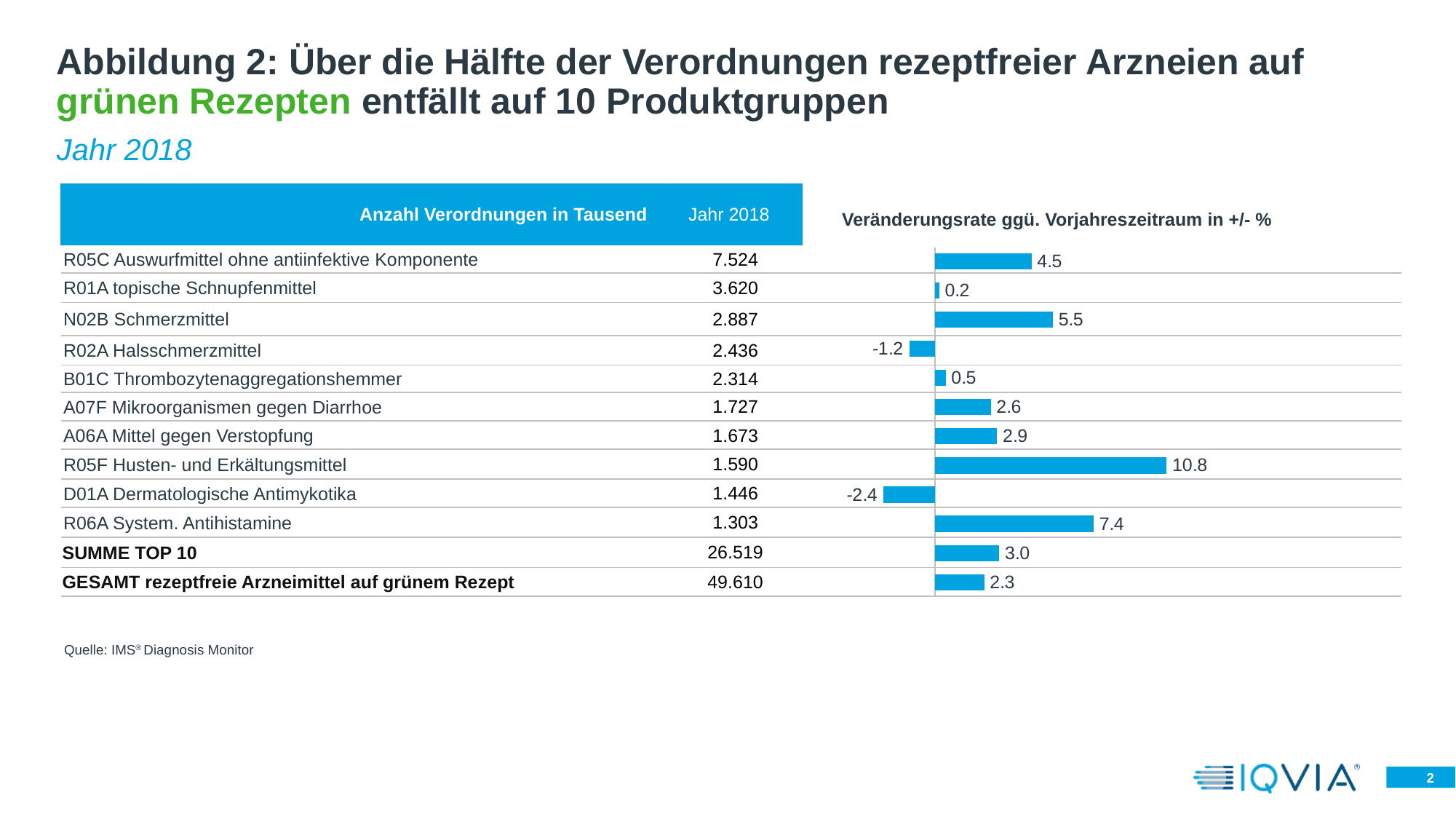
What is the change rate shown for GESAMT rezeptfreie Arzneimittel auf grünem Rezept? 2.3 What is the heading above the bar chart? Veränderungsrate ggü. Vorjahreszeitraum in +/- % What kind of chart is used to show the Veränderungsrate? Bar chart What is the change rate shown for SUMME TOP 10? 3.0 Which product group has the highest change rate in the bar chart? R05F Husten- und Erkältungsmittel How many bars are shown in the change rate chart? 12 How many product groups show a negative change rate? 2 What is the change rate (Veränderungsrate) shown for R05F Husten- und Erkältungsmittel? 10.8 What is the difference between the change rates of R05F Husten- und Erkältungsmittel and R06A System. Antihistamine? 3.4 Which product group has the lowest change rate in the bar chart? D01A Dermatologische Antimykotika What is the change rate shown for D01A Dermatologische Antimykotika? -2.4 Which has a larger change rate: N02B Schmerzmittel or R05C Auswurfmittel ohne antiinfektive Komponente? N02B Schmerzmittel